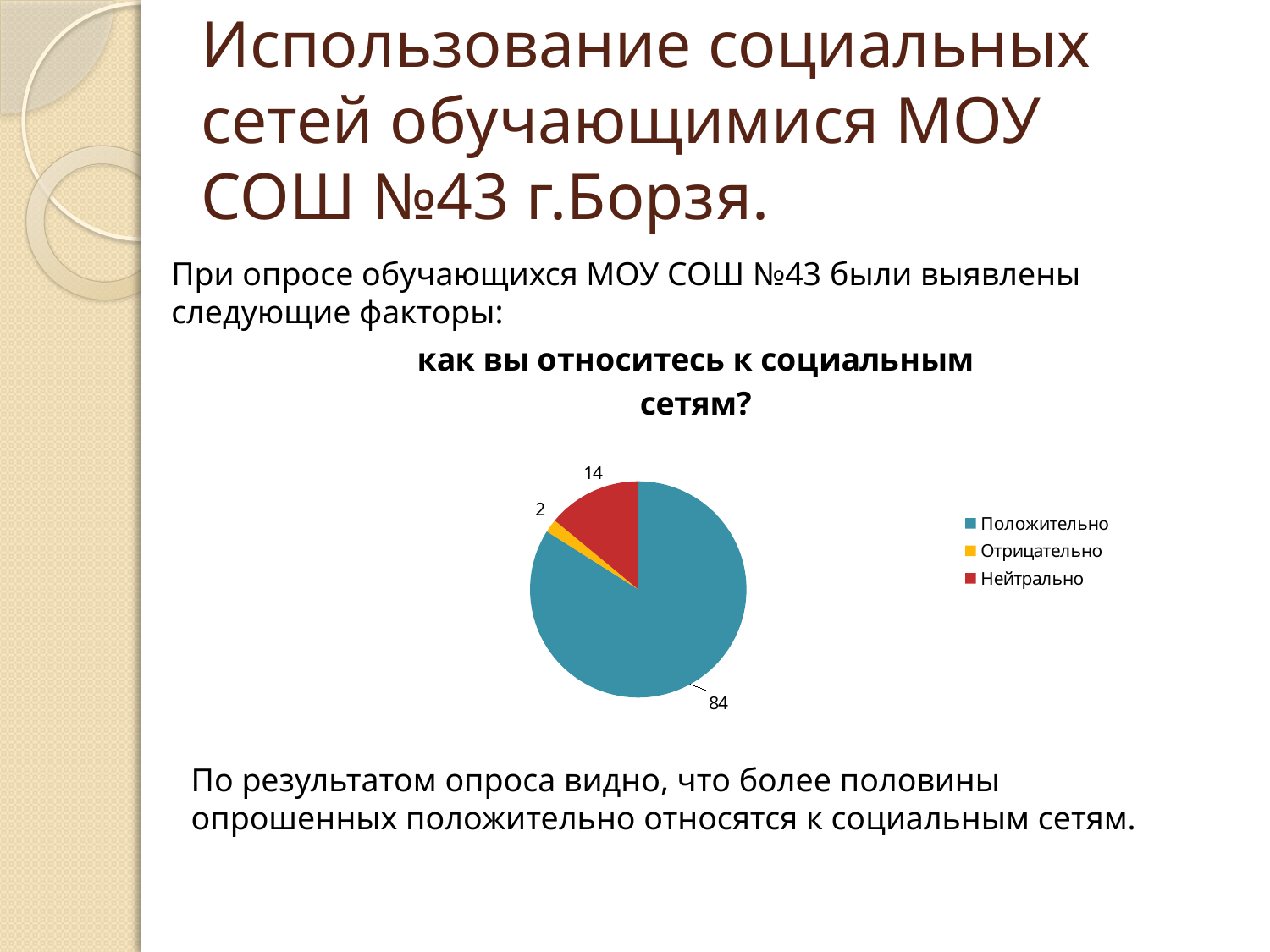
What is the value for Нейтрально in the pie chart? 14 What is the title of the pie chart? как вы относитесь к социальным сетям? What share of the pie does the Положительно slice represent? 84% Which category has the smallest slice in the pie chart? Отрицательно What is the value for Отрицательно in the pie chart? 2 Which category has the largest slice in the pie chart? Положительно What is the value for Положительно in the pie chart? 84 What is the difference between the values for Нейтрально and Отрицательно? 12 Which is larger, the value for Нейтрально or the value for Отрицательно? Нейтрально What kind of chart is shown on the slide? pie chart What is the difference between the values for Положительно and Нейтрально? 70 How many categories does the pie chart show? 3